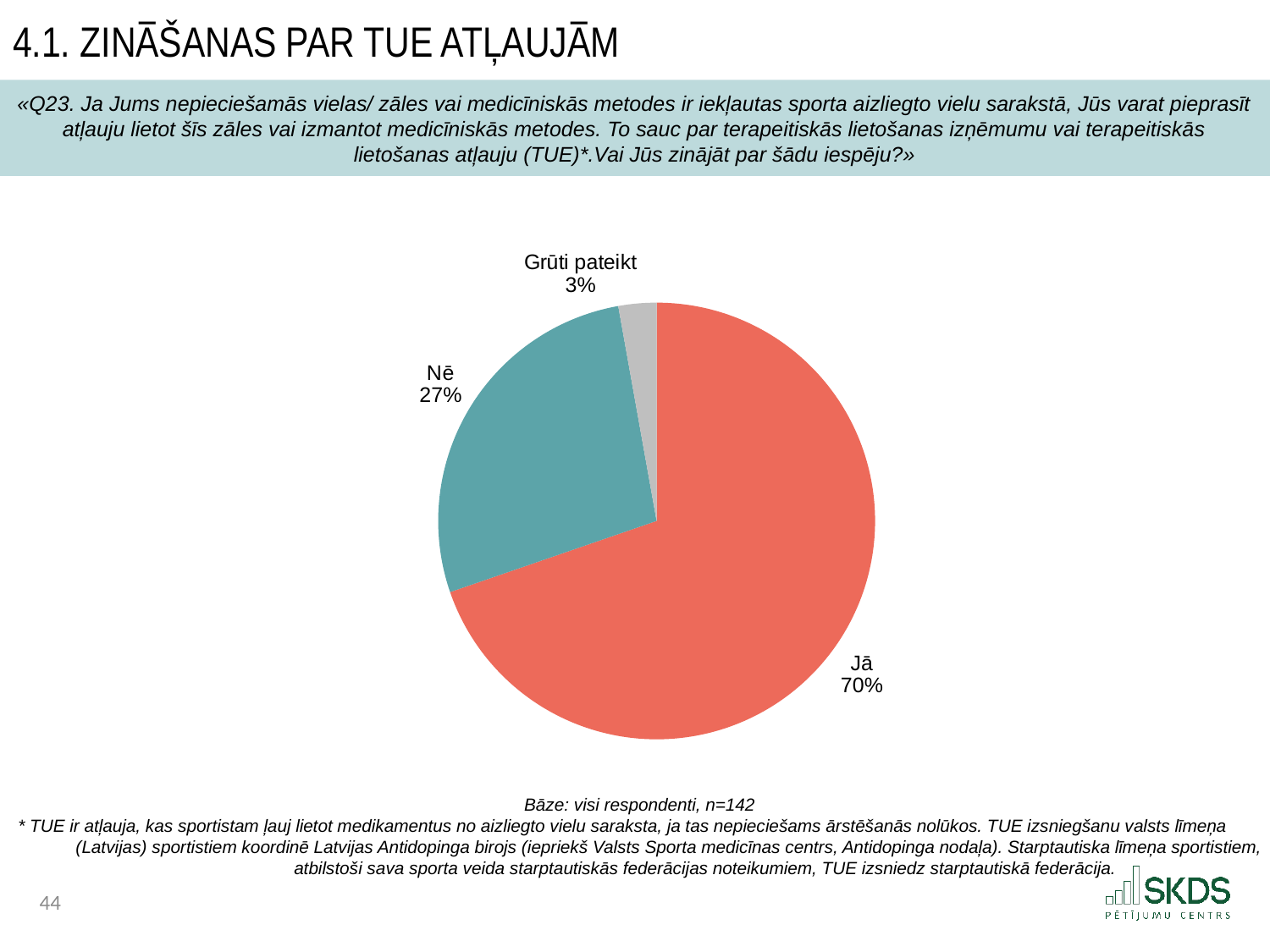
How many slices does the pie chart have? 3 What kind of chart is shown on the slide? pie chart What share of respondents answered "Nē"? 27% What share of respondents answered "Grūti pateikt"? 3% What colour is the "Jā" slice of the pie? red What share of respondents answered "Jā"? 70% What is the difference in percentage points between the "Jā" and "Nē" slices? 43 Which slice is larger, "Nē" or "Grūti pateikt"? Nē Which answer has the smallest slice of the pie? Grūti pateikt Which answer has the largest slice of the pie? Jā What is the combined share of the "Nē" and "Grūti pateikt" slices? 30% What is the base (number of respondents) stated below the chart? n=142